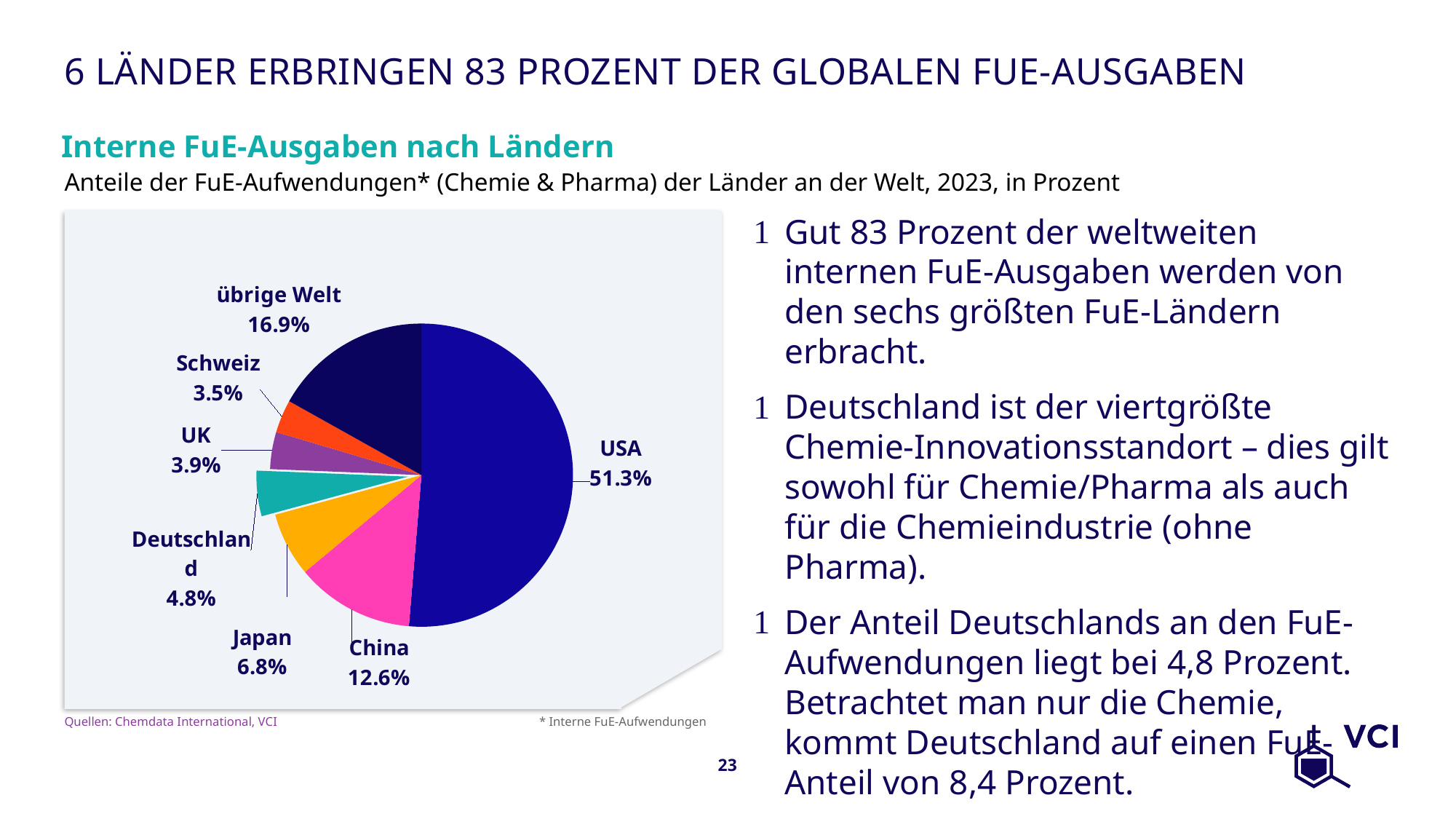
How many slices does the pie chart have? 7 Which is larger, the share of UK or the share of Schweiz? UK What share of the pie does the USA hold? 51.3% What kind of chart is shown on the slide? Pie chart What is the value shown for übrige Welt? 16.9% What is the combined share of Japan and Deutschland? 11.6% What is the title of the chart? Interne FuE-Ausgaben nach Ländern What is the difference between the shares of China and Japan? 5.8% What is the value shown for China? 12.6% Which category has the smallest slice of the pie? Schweiz What is the value shown for Deutschland? 4.8% Which category has the largest slice of the pie? USA